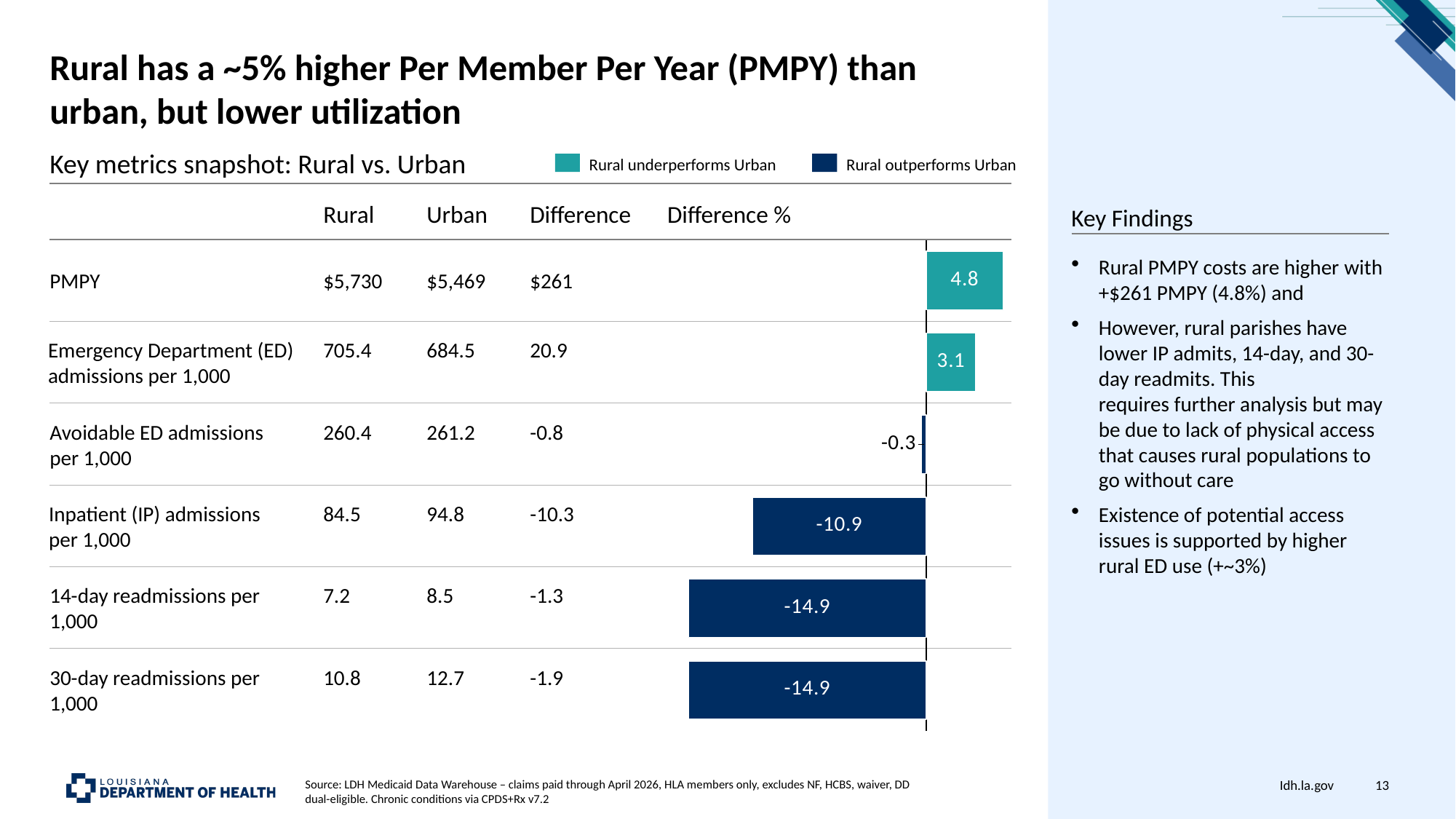
How many metrics (bars) are shown in the Difference % chart? 6 How many entries does the legend above the chart list? 2 What is the Difference % value for PMPY? 4.8 What is the Difference % value for Inpatient (IP) admissions per 1,000? -10.9 What is the Difference % value for 30-day readmissions per 1,000? -14.9 What is the difference between the Difference % for PMPY and for Emergency Department (ED) admissions per 1,000? 1.7 What colour are the bars labelled 'Rural outperforms Urban' in the legend? dark blue What is the Difference % value for Avoidable ED admissions per 1,000? -0.3 What is the Rural value for PMPY in the table? $5,730 Which has a larger Difference % value, PMPY or Emergency Department (ED) admissions per 1,000? PMPY What kind of chart shows the Difference % values on the slide? bar chart Which metric has the highest Difference % bar? PMPY